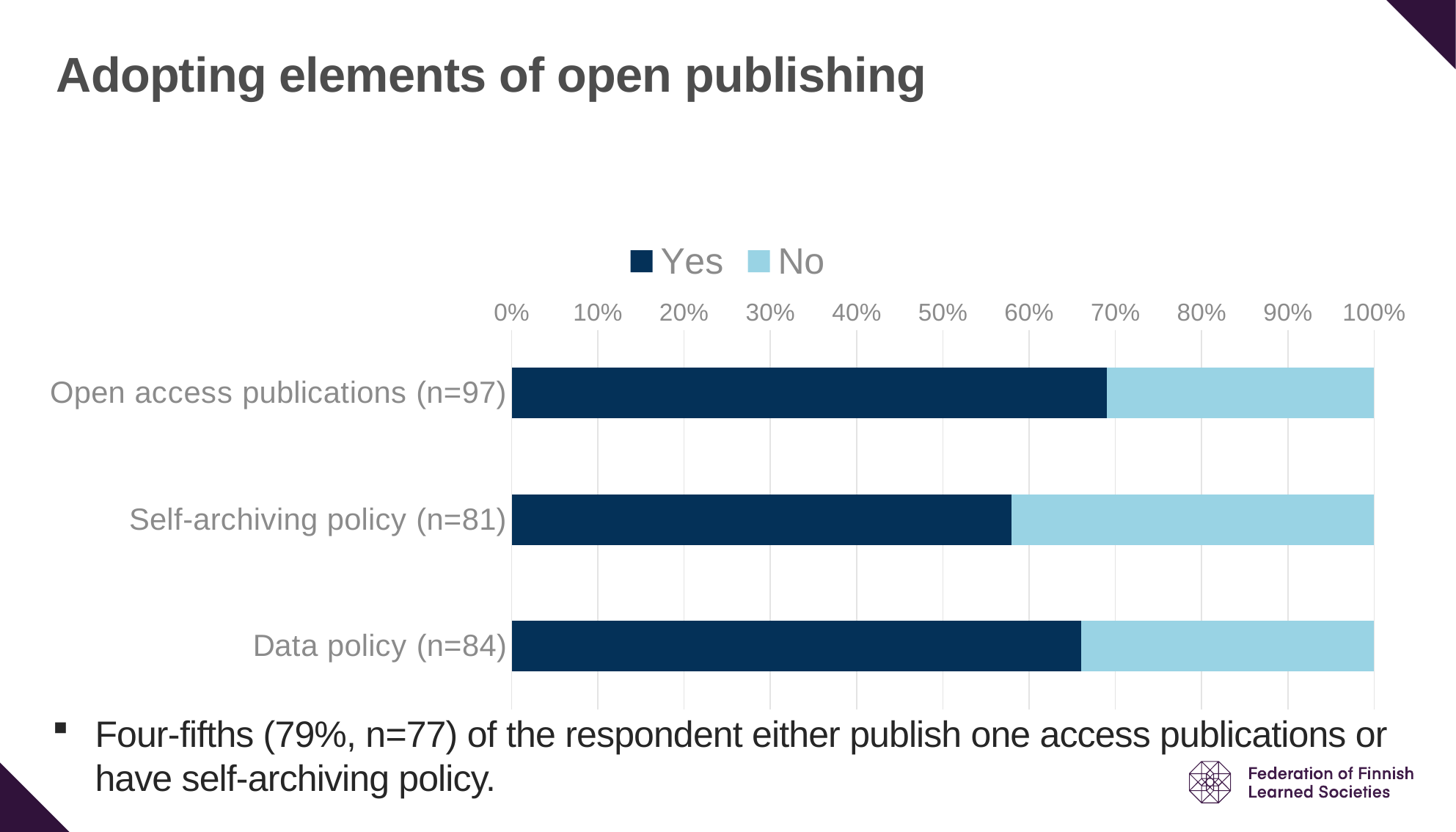
Is the 'No' value for Open access publications (n=97) greater or less than 40%? less Which is larger: the 'No' share for Self-archiving policy (n=81) or the 'No' share for Open access publications (n=97)? Self-archiving policy (n=81) How many categories are plotted on the chart? 3 What kind of chart is shown on the slide? Stacked bar chart How many series does the legend list? 2 Is the 'Yes' value for Data policy (n=84) greater or less than 60%? greater What is the title of the slide containing the chart? Adopting elements of open publishing Which category has the highest 'No' share? Self-archiving policy (n=81) Which colour represents the 'No' series in the chart? Light blue Is the 'Yes' value for Open access publications (n=97) greater or less than 60%? greater Which category has the lowest 'Yes' share? Self-archiving policy (n=81)